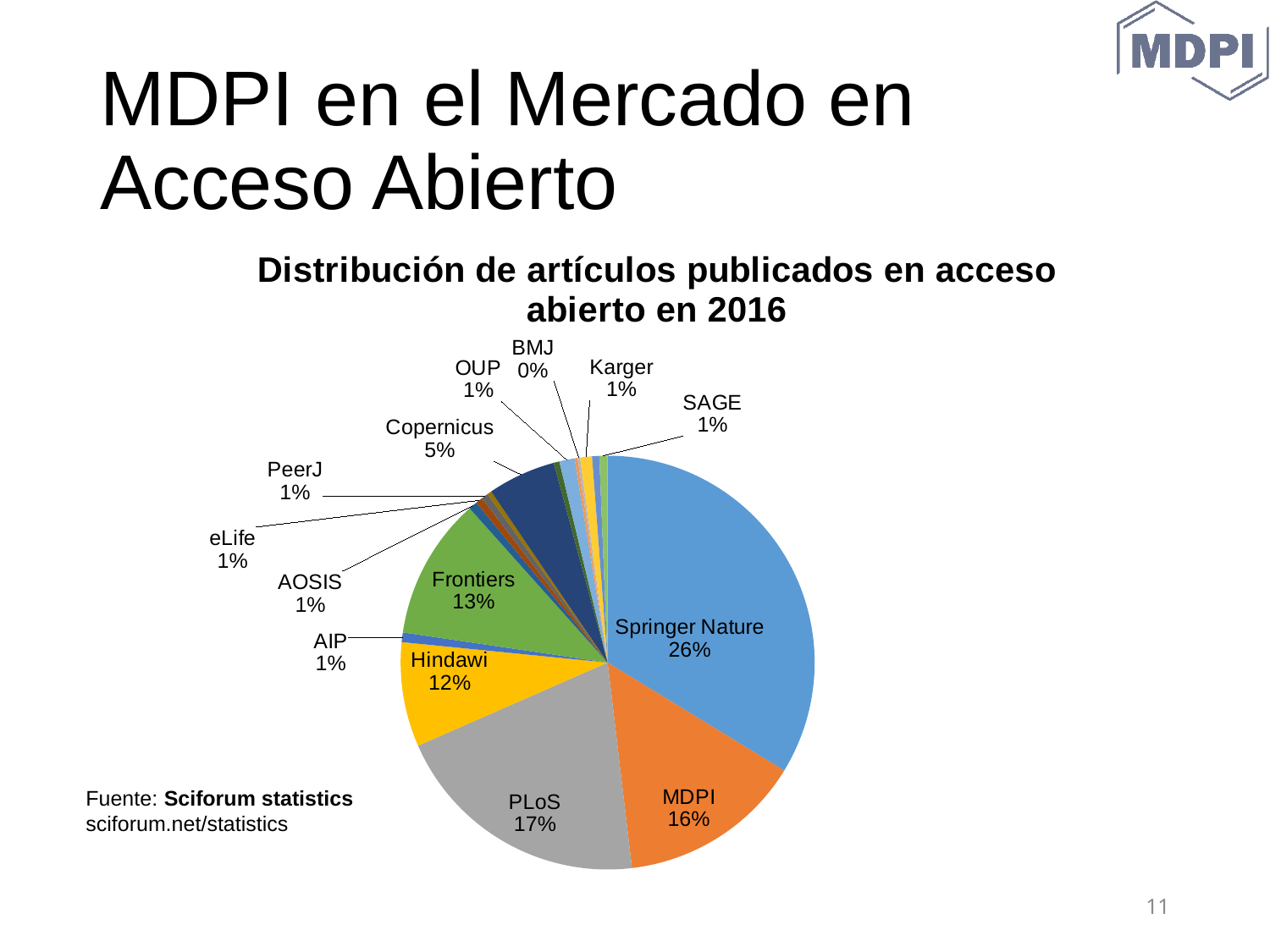
What type of chart is shown on the slide? Pie chart Which publisher has the smallest slice of the pie? BMJ What share of the pie does MDPI hold? 16% What is the title of the chart? Distribución de artículos publicados en acceso abierto en 2016 Which is larger, the share for Frontiers or the share for Hindawi? Frontiers Which publisher has the largest slice of the pie? Springer Nature What share of the pie does Copernicus hold? 5% What share of the pie does Springer Nature hold? 26% What is the difference in percentage points between Springer Nature's share and MDPI's share? 10 percentage points What is the combined share of PLoS and Hindawi? 29%